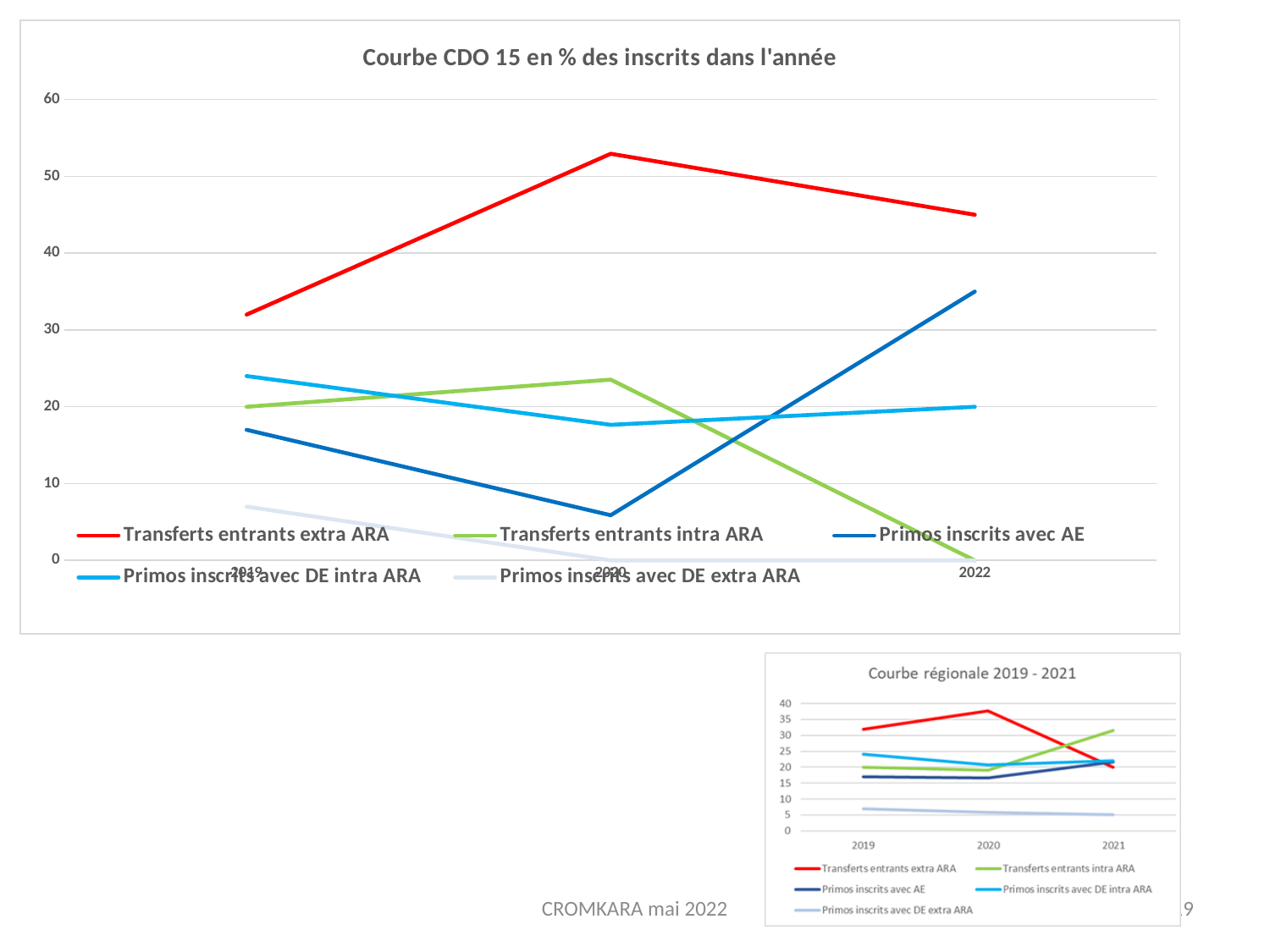
In the 'Courbe CDO 15 en % des inscrits dans l'année' chart, is the value for Primos inscrits avec AE in 2022 greater or less than 30? greater In the 'Courbe régionale 2019 - 2021' chart, is the value for Transferts entrants extra ARA in 2020 greater or less than 30? greater What kind of chart is the 'Courbe CDO 15 en % des inscrits dans l'année' chart? line chart In the 'Courbe CDO 15 en % des inscrits dans l'année' chart, does the Transferts entrants extra ARA line rise or fall from 2019 to 2020? rise In the 'Courbe CDO 15 en % des inscrits dans l'année' chart, which series has the highest value in 2020? Transferts entrants extra ARA In the 'Courbe CDO 15 en % des inscrits dans l'année' chart, which is larger in 2022: Primos inscrits avec AE or Primos inscrits avec DE intra ARA? Primos inscrits avec AE In the 'Courbe régionale 2019 - 2021' chart, which series has the highest value in 2021? Transferts entrants intra ARA In the 'Courbe CDO 15 en % des inscrits dans l'année' chart, which series has the lowest value in 2019? Primos inscrits avec DE extra ARA How many years are shown on the x axis of the 'Courbe régionale 2019 - 2021' chart? 3 How many years are shown on the x axis of the 'Courbe CDO 15 en % des inscrits dans l'année' chart? 3 How many series does the legend of the 'Courbe CDO 15 en % des inscrits dans l'année' chart list? 5 In the 'Courbe CDO 15 en % des inscrits dans l'année' chart, is the value for Transferts entrants extra ARA in 2020 greater or less than 50? greater